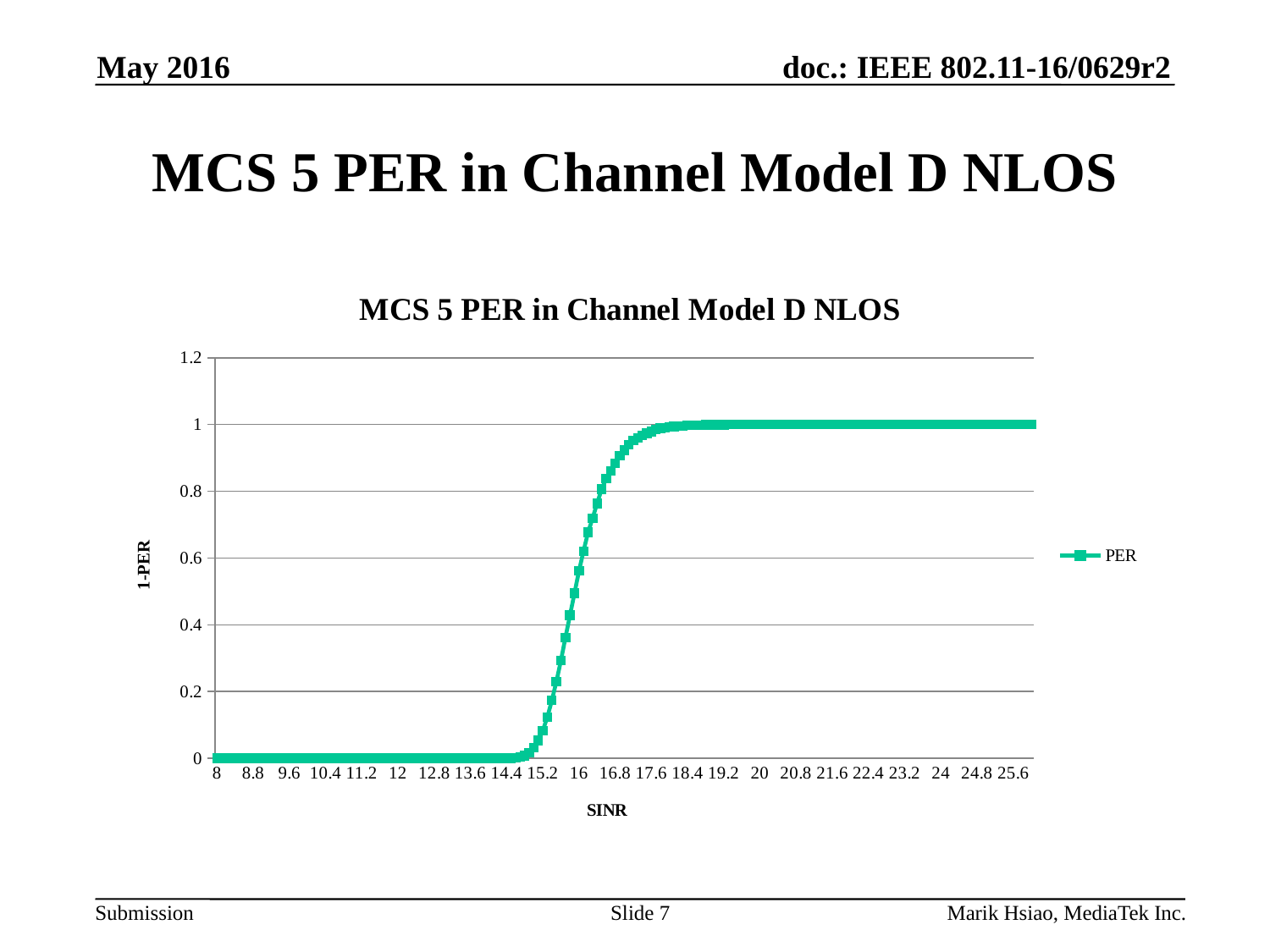
What is the name of the series shown in the legend? PER What is the title of the chart? MCS 5 PER in Channel Model D NLOS What kind of chart is shown on the slide? line chart What is the value of the PER series at SINR 24? 1 What is the value of the PER series at SINR 8? 0 Is the value of the PER series at SINR 15.2 greater or less than 0.2? less Is the value of the PER series at SINR 14.4 greater or less than 0.2? less Do the plotted values rise or fall as SINR increases from 8 to 25.6? rise How many series does the legend list? 1 Which is larger, the PER series value at SINR 12 or at SINR 20? SINR 20 Is the value of the PER series at SINR 16.8 greater or less than 0.8? greater